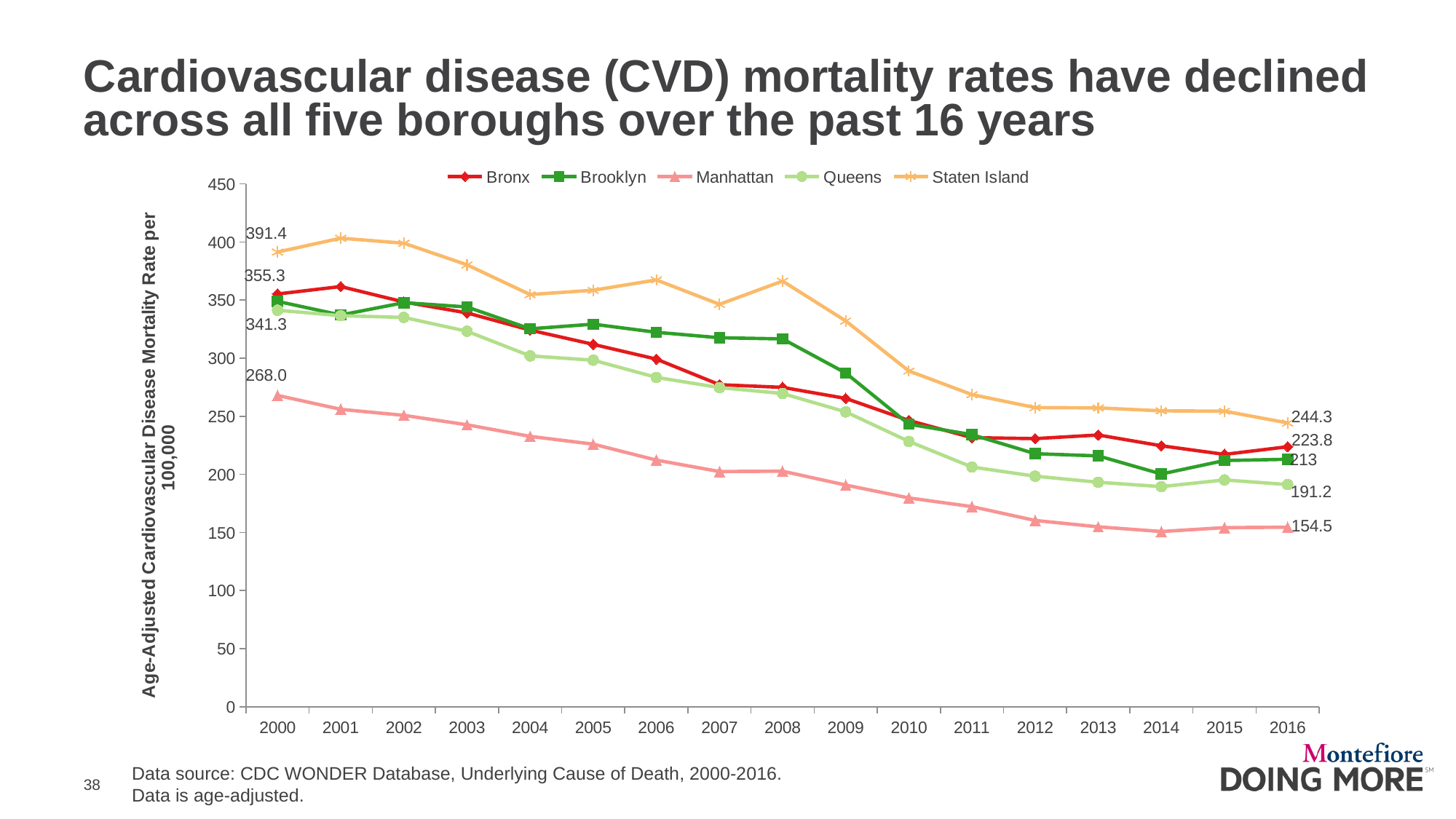
What is the CVD mortality rate for Staten Island in 2000? 391.4 Which borough has the highest CVD mortality rate in 2016? Staten Island What is the CVD mortality rate for Queens in 2016? 191.2 Which borough has the lowest CVD mortality rate in 2016? Manhattan What is the CVD mortality rate for the Bronx in 2000? 355.3 By how much did the Bronx CVD mortality rate fall from 2000 (355.3) to 2016 (223.8)? 131.5 Is the Staten Island value for 2008 greater or less than 350? greater What is the CVD mortality rate for Staten Island in 2016? 244.3 What is the CVD mortality rate for Manhattan in 2016? 154.5 Which is larger in 2016, the Bronx rate or the Brooklyn rate? Bronx How many series does the legend list? 5 What is the difference between the Staten Island and Manhattan CVD mortality rates in 2016? 89.8